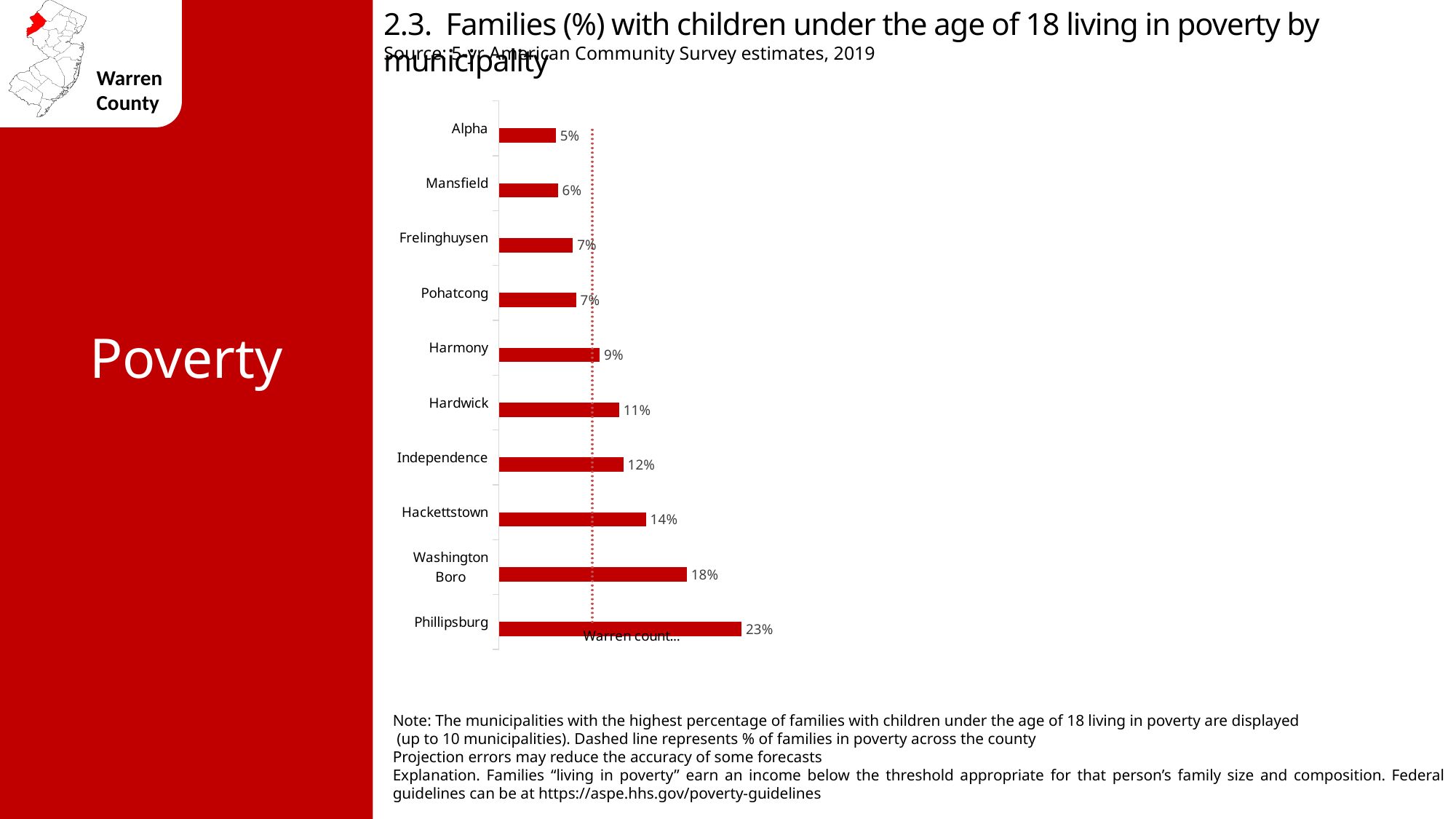
What is the value for Harmony? 9% Which has a higher value, Hardwick or Mansfield? Hardwick What kind of chart is shown on the slide? Bar chart What is the value for Phillipsburg? 23% What is the difference between the values for Hackettstown and Independence? 2% What does the dashed vertical line in the chart represent? % of families in poverty across the county Which municipality has the highest percentage of families with children under 18 living in poverty? Phillipsburg What is the value for Washington Boro? 18% What is the value for Hackettstown? 14% Which municipality has the lowest percentage of families with children under 18 living in poverty? Alpha What is the difference between the values for Phillipsburg and Washington Boro? 5% How many municipalities are shown in the chart? 10